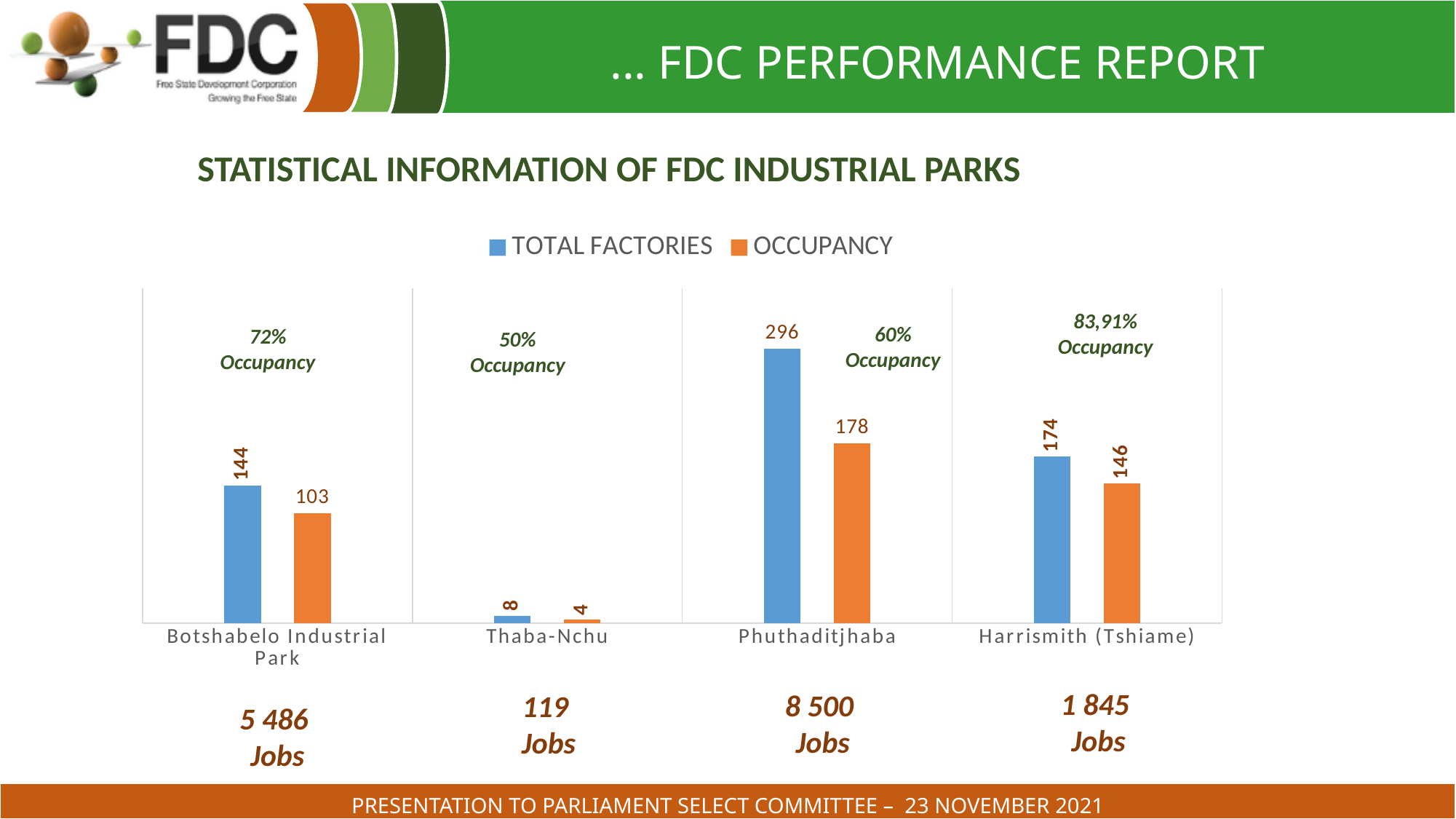
Which industrial park has the lowest OCCUPANCY value? Thaba-Nchu What is the TOTAL FACTORIES value for Thaba-Nchu? 8 How many industrial parks are shown on the x axis of the chart? 4 What kind of chart is shown on the slide? Bar chart Which is larger: the OCCUPANCY value for Phuthaditjhaba or the TOTAL FACTORIES value for Harrismith (Tshiame)? OCCUPANCY for Phuthaditjhaba What is the OCCUPANCY value for Harrismith (Tshiame)? 146 What is the difference between TOTAL FACTORIES for Harrismith (Tshiame) and Botshabelo Industrial Park? 30 What is the difference between TOTAL FACTORIES and OCCUPANCY for Phuthaditjhaba? 118 What is the TOTAL FACTORIES value for Phuthaditjhaba? 296 What is the OCCUPANCY value for Botshabelo Industrial Park? 103 How many series does the chart legend list? 2 Which industrial park has the highest TOTAL FACTORIES value? Phuthaditjhaba